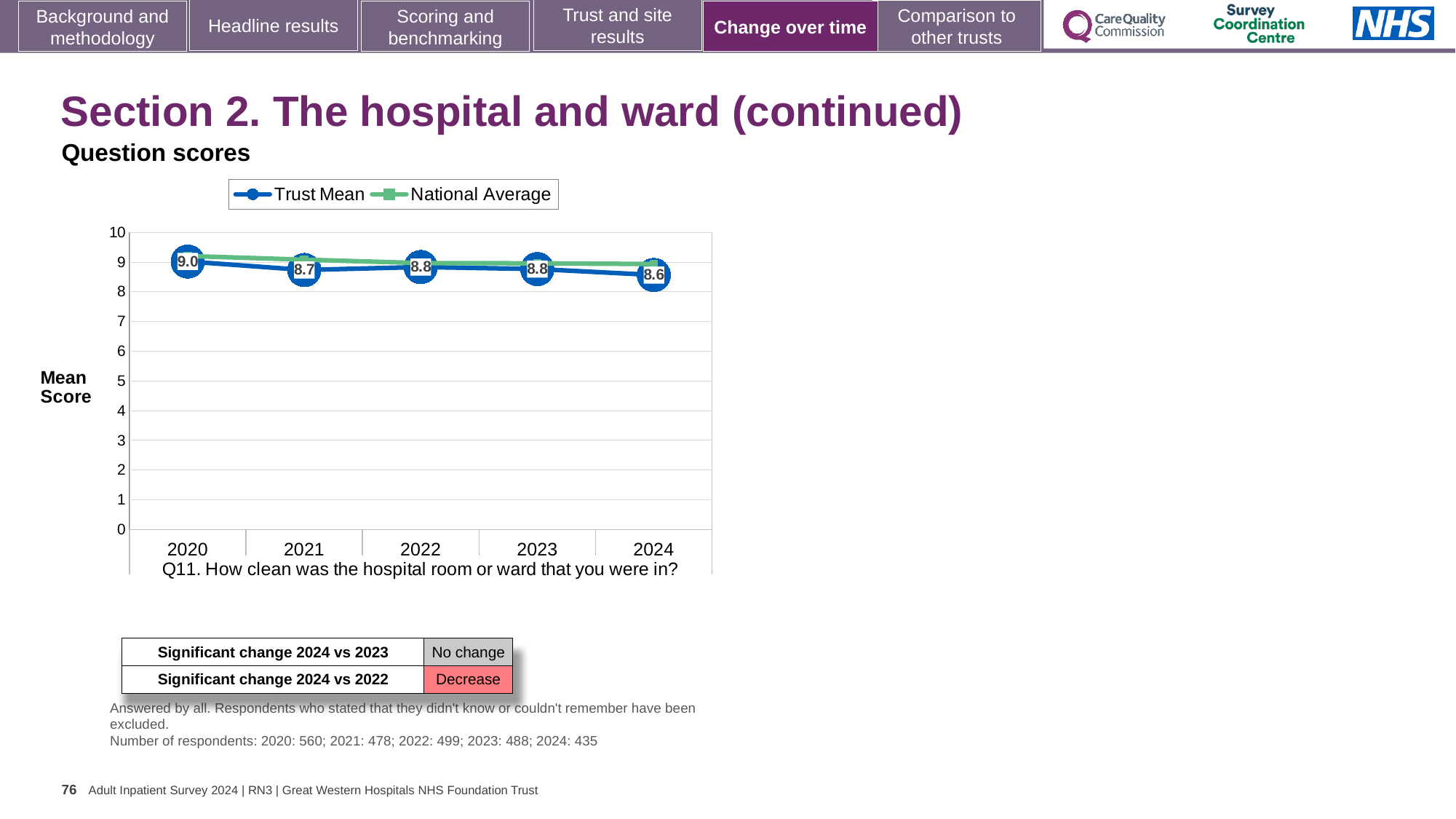
What is the Trust Mean value for 2021? 8.7 What is the difference between the Trust Mean in 2020 and in 2024? 0.4 How many series does the chart legend list? 2 Which year has the larger Trust Mean, 2020 or 2021? 2020 Is the National Average value for 2020 greater or less than 8? greater In which year is the Trust Mean highest? 2020 Does the Trust Mean rise or fall overall from 2020 to 2024? Fall What is the Trust Mean value for 2020? 9.0 What kind of chart is shown on the slide? Line chart What is the Trust Mean value for 2024? 8.6 How many years are shown on the x axis of the chart? 5 In which year is the Trust Mean lowest? 2024